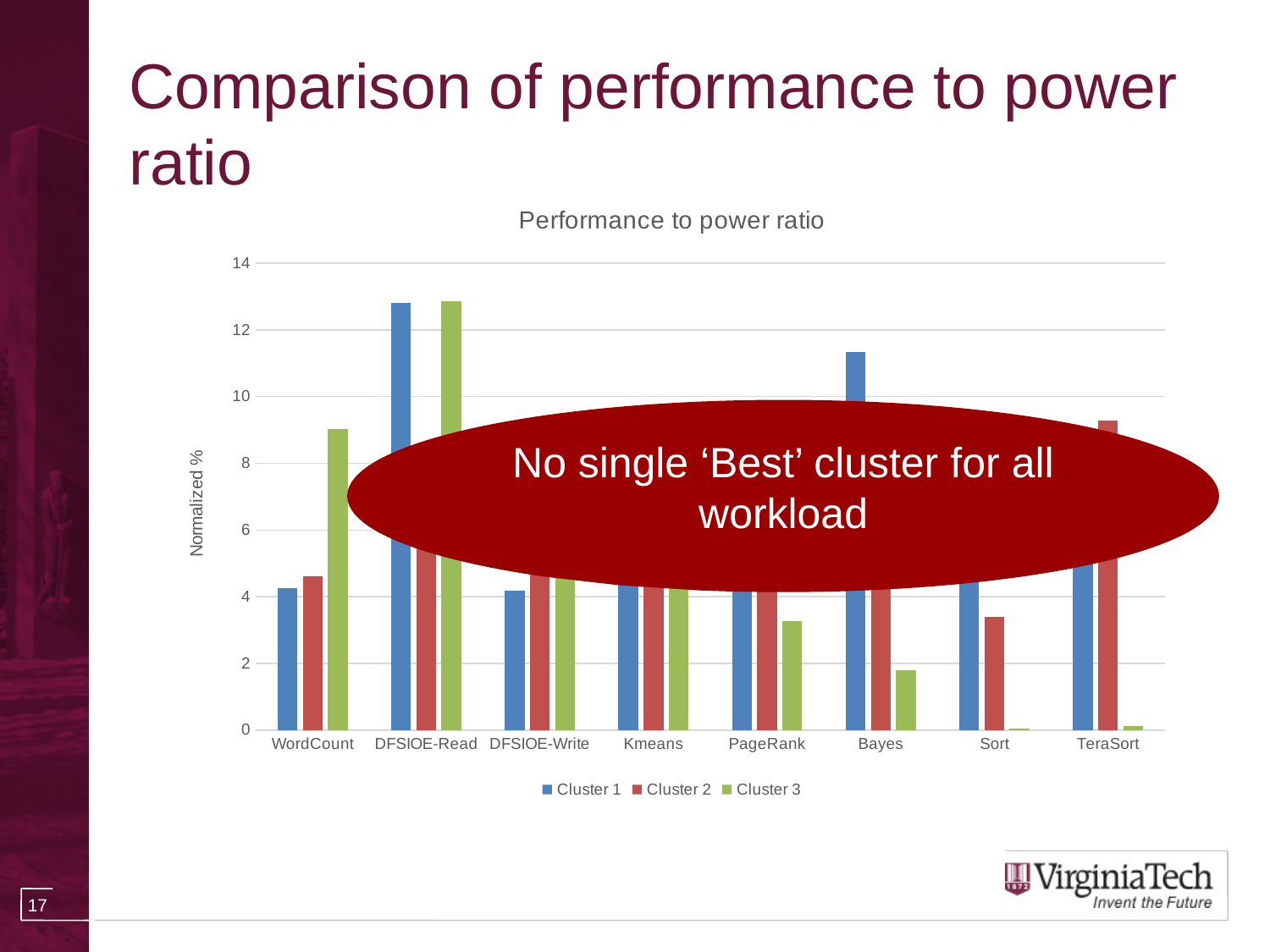
Is the value for Cluster 1 on DFSIOE-Read greater or less than 12? greater What is the label on the vertical axis of the chart? Normalized % Is the value for Cluster 3 on WordCount greater or less than 8? greater How many series does the chart's legend list? 3 Is the value for Cluster 3 on Bayes greater or less than 2? less What is the title of the chart? Performance to power ratio For which workload does Cluster 3 have its highest value? DFSIOE-Read What kind of chart is shown on the slide? bar chart For Bayes, which is larger: Cluster 1 or Cluster 3? Cluster 1 How many workload categories are shown on the x axis of the chart? 8